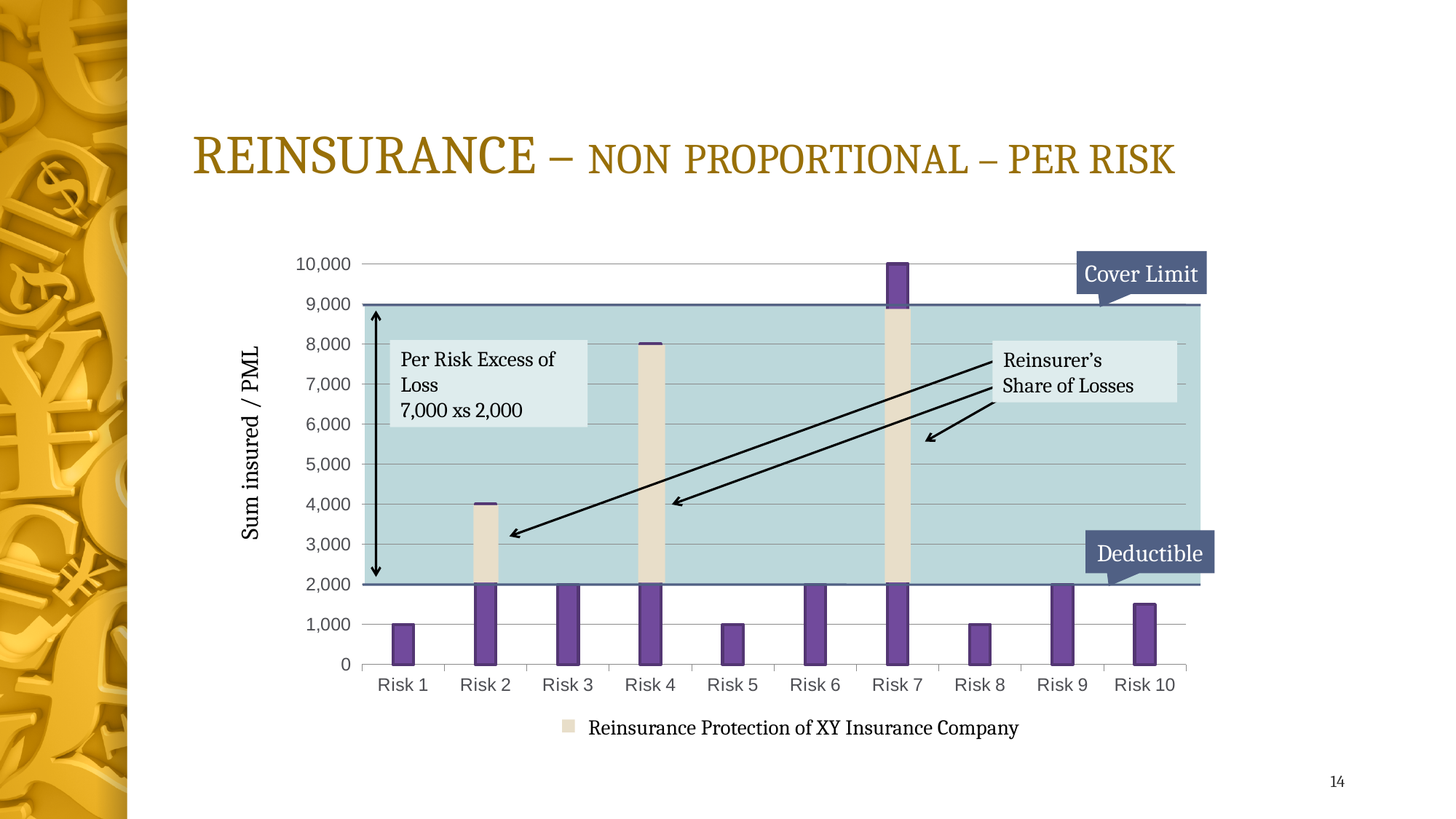
Which is larger, the value for Risk 2 or the value for Risk 4? Risk 4 Which risk has the highest sum insured? Risk 7 What kind of chart is shown on the slide? bar chart How many risks are shown on the x axis? 10 What is the value for Risk 4? 8,000 What is the value for Risk 7? 10,000 What is the value for Risk 2? 4,000 Is the value for Risk 10 greater or less than 2,000? less What is the label of the vertical axis? Sum insured / PML What is the difference between the values for Risk 7 and Risk 4? 2,000 Is the value for Risk 10 greater or less than 1,000? greater How many series does the legend list? 1